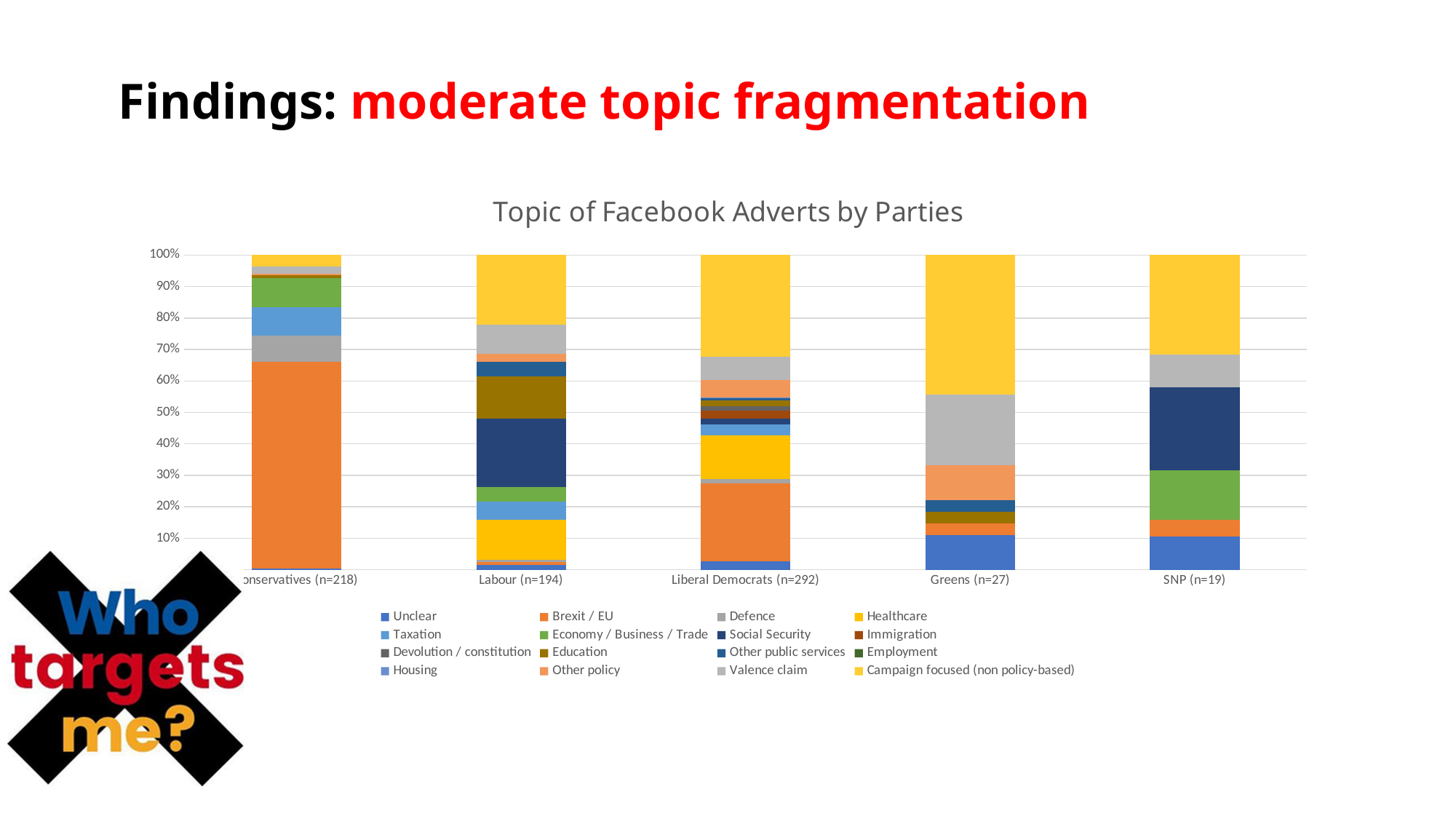
What is the sample size (n) shown for Liberal Democrats? 292 Is the Social Security share for SNP greater or less than 20%? greater Which party has the largest Brexit / EU share? Conservatives (n=218) Is the Brexit / EU share for Conservatives greater or less than 60%? greater How many topic series does the legend list? 16 Is the Campaign focused (non policy-based) share for Conservatives greater or less than 10%? less Is the Brexit / EU share larger for Conservatives or for Liberal Democrats? Conservatives What is the title of the chart? Topic of Facebook Adverts by Parties What is the sample size (n) shown for SNP? 19 How many parties are shown on the x axis of the chart? 5 What type of chart is shown on the slide? Stacked bar chart Which party has the largest Campaign focused (non policy-based) share? Greens (n=27)